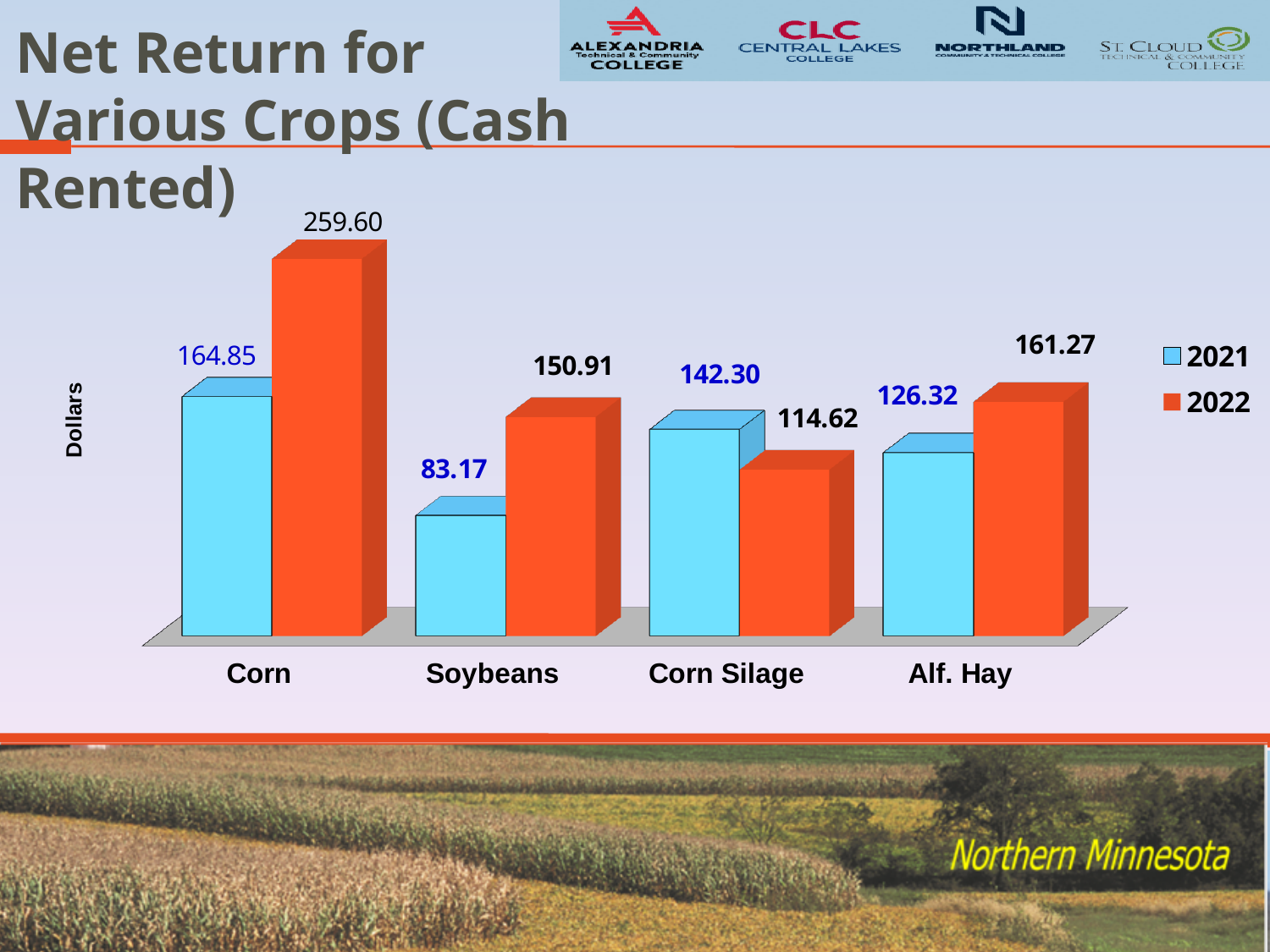
What is the 2021 net return for Alf. Hay? 126.32 Which crop has the lowest 2021 net return? Soybeans Which crop has the highest 2022 net return? Corn How many series does the legend list? 2 What is the 2021 net return for Soybeans? 83.17 Which is larger for Corn Silage, the 2021 or the 2022 net return? 2021 What is the label on the vertical axis? Dollars What is the 2022 net return for Corn Silage? 114.62 How many crops are shown on the x axis? 4 What is the difference between the 2022 and 2021 net return for Corn? 94.75 What kind of chart is shown on the slide? Bar chart What is the 2022 net return for Corn? 259.60